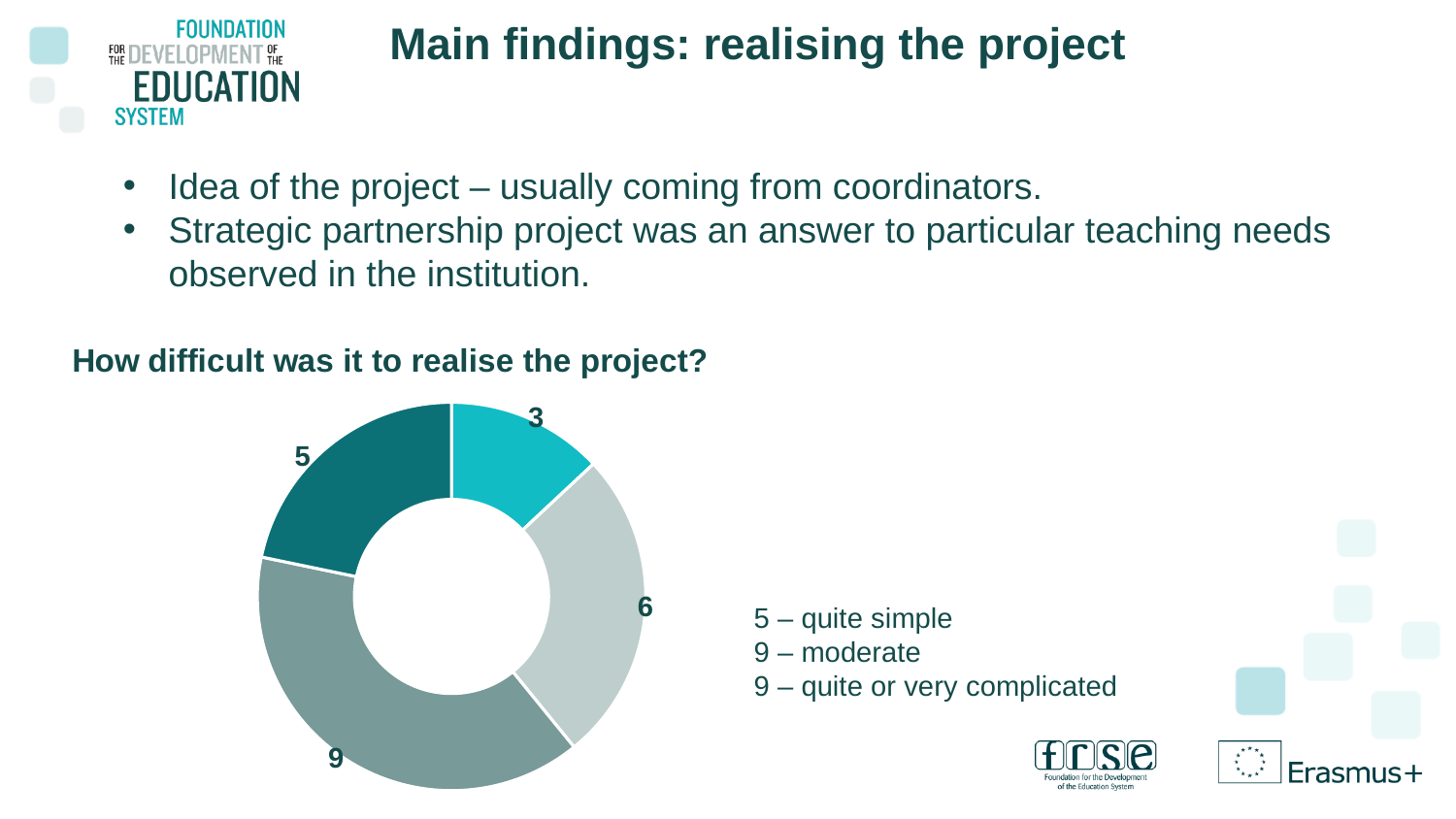
What question is the doughnut chart answering, according to the heading above it? How difficult was it to realise the project? What is the value of the dark teal slice in the doughnut chart? 5 How many slices does the doughnut chart have? 4 What is the difference between the slice labelled 9 and the slice labelled 6? 3 What colour is the slice labelled 3 in the doughnut chart? bright turquoise What is the value of the light grey slice in the doughnut chart? 6 What is the difference between the largest and smallest slice values in the doughnut chart? 6 Which is larger in the doughnut chart: the slice labelled 6 or the slice labelled 5? the slice labelled 6 What is the value of the largest slice in the doughnut chart? 9 What kind of chart is shown under the question "How difficult was it to realise the project?"? doughnut chart What is the value of the smallest slice in the doughnut chart? 3 What is the total of all the slice values in the doughnut chart? 23